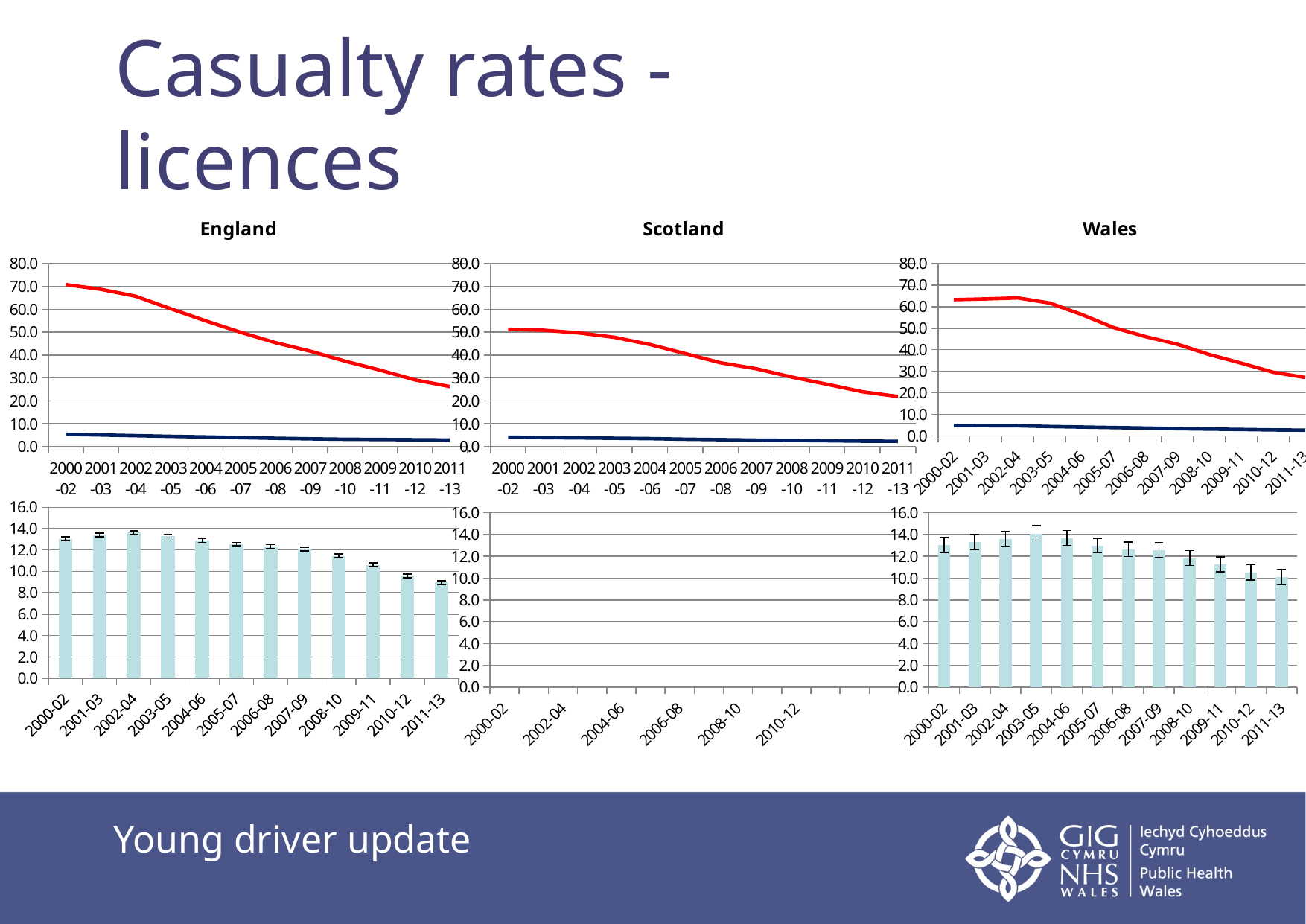
In the Wales bar chart, which is larger, the value for 2003-05 or the value for 2011-13? 2003-05 In the Wales line chart, is the red line's value for 2000-02 greater or less than 50.0? greater What kind of chart is the England chart in the top row of the slide? Line chart In the England line chart, how many lines are plotted? 2 In the England bar chart, how many bars are plotted? 12 In the England line chart, does the red line rise or fall from 2000-02 to 2011-13? Fall In the Scotland line chart, is the red line's value for 2011-13 greater or less than 30.0? less What kind of chart is the England chart in the bottom row of the slide? Bar chart In the England bar chart, which period has the lowest bar? 2011-13 In the England bar chart, is the value for 2011-13 greater or less than 10.0? less Does the Scotland bar chart in the bottom row show any bars? No